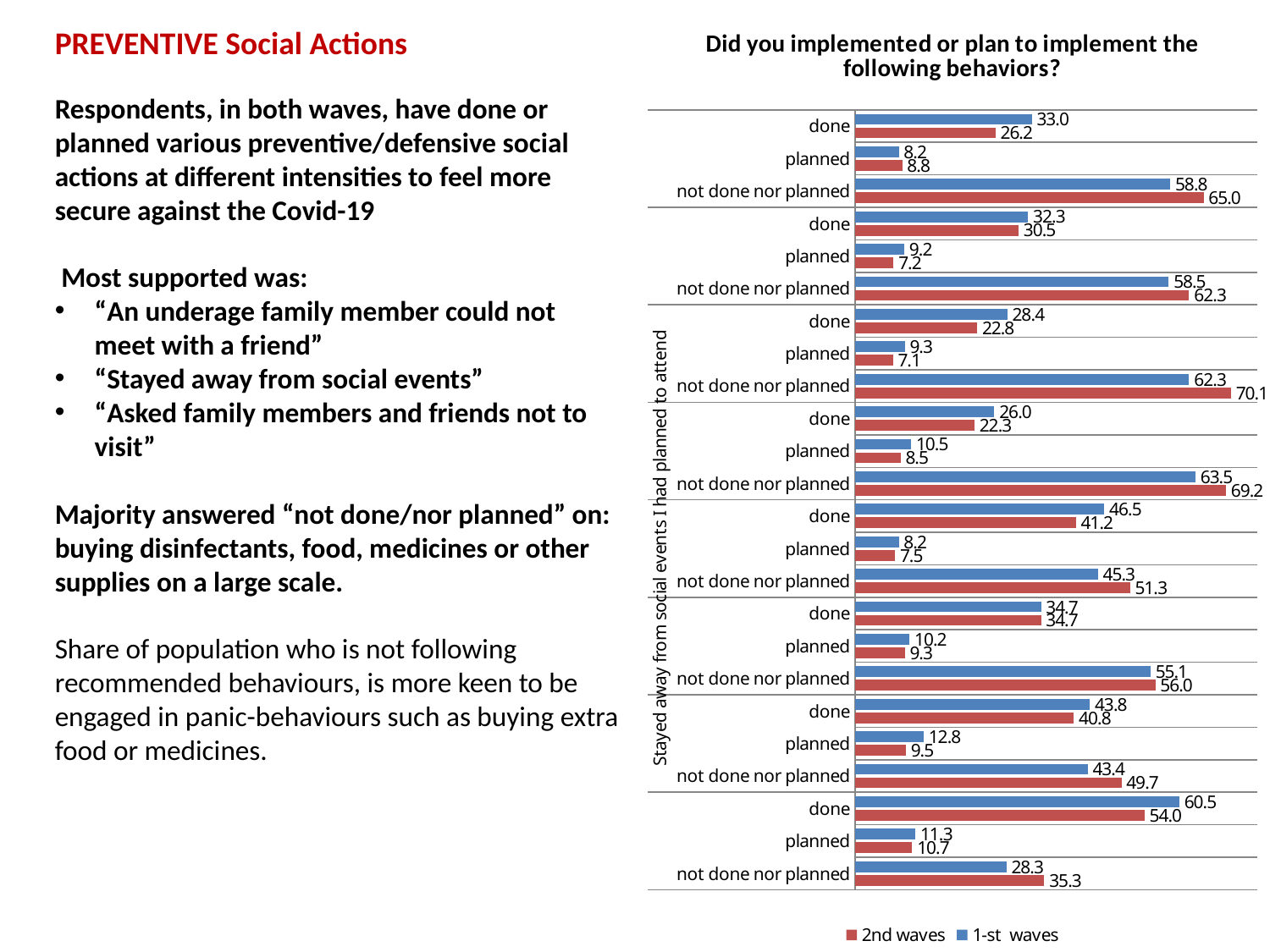
In the topmost group of bars, what is the 1-st waves value for "done"? 33.0 In the bottom group of bars, what is the 2nd waves value for "not done nor planned"? 35.3 What kind of chart is shown on the slide? bar chart What are the two series named in the chart legend? 2nd waves and 1-st waves How many series does the chart legend list? 2 In the bottom group of bars, what is the 2nd waves value for "planned"? 10.7 What is the highest value labelled anywhere on the chart? 70.1 How many groups of "done / planned / not done nor planned" bars does the chart contain? 8 What is the title of the chart? Did you implemented or plan to implement the following behaviors? In the bottom group of bars, what is the difference between the 1-st waves and 2nd waves values for "done"? 6.5 In the topmost group of bars, what is the difference between the 2nd waves and 1-st waves values for "not done nor planned"? 6.2 In the bottom group of bars, which series has the larger value for "done", 2nd waves or 1-st waves? 1-st waves